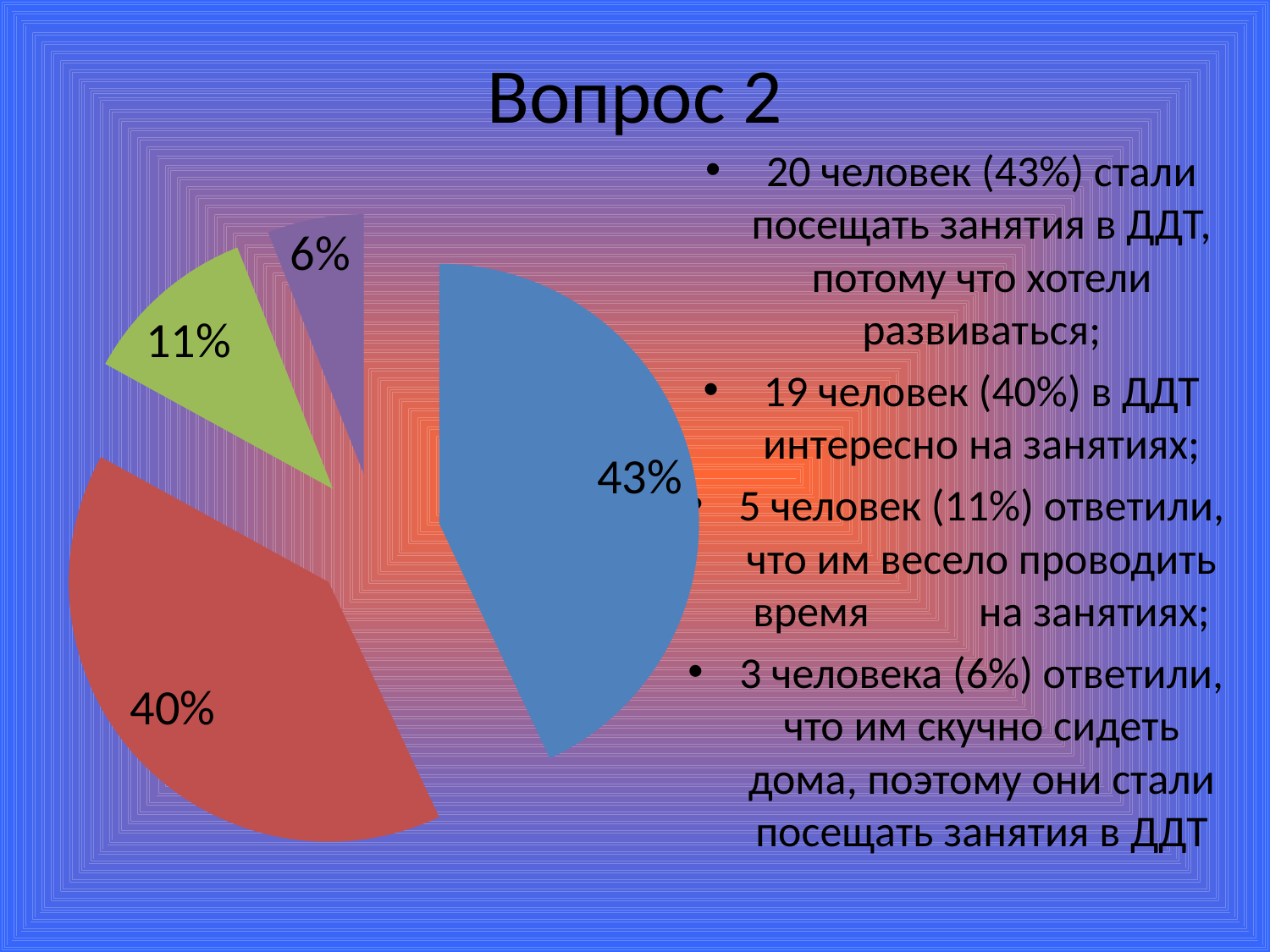
Which slice of the pie chart is the largest? the blue slice (43%) What is the title of the slide containing the pie chart? Вопрос 2 What percentage is shown on the purple slice of the pie chart? 6% Which slice of the pie chart is the smallest? the purple slice (6%) What percentage is shown on the red slice of the pie chart? 40% What is the difference between the green slice and the purple slice of the pie chart? 5% What percentage is shown on the green slice of the pie chart? 11% What percentage is shown on the blue slice of the pie chart? 43% What kind of chart is shown on the slide? pie chart Which is larger in the pie chart, the green slice or the purple slice? the green slice How many slices does the pie chart have? 4 What is the difference between the blue slice and the red slice of the pie chart? 3%